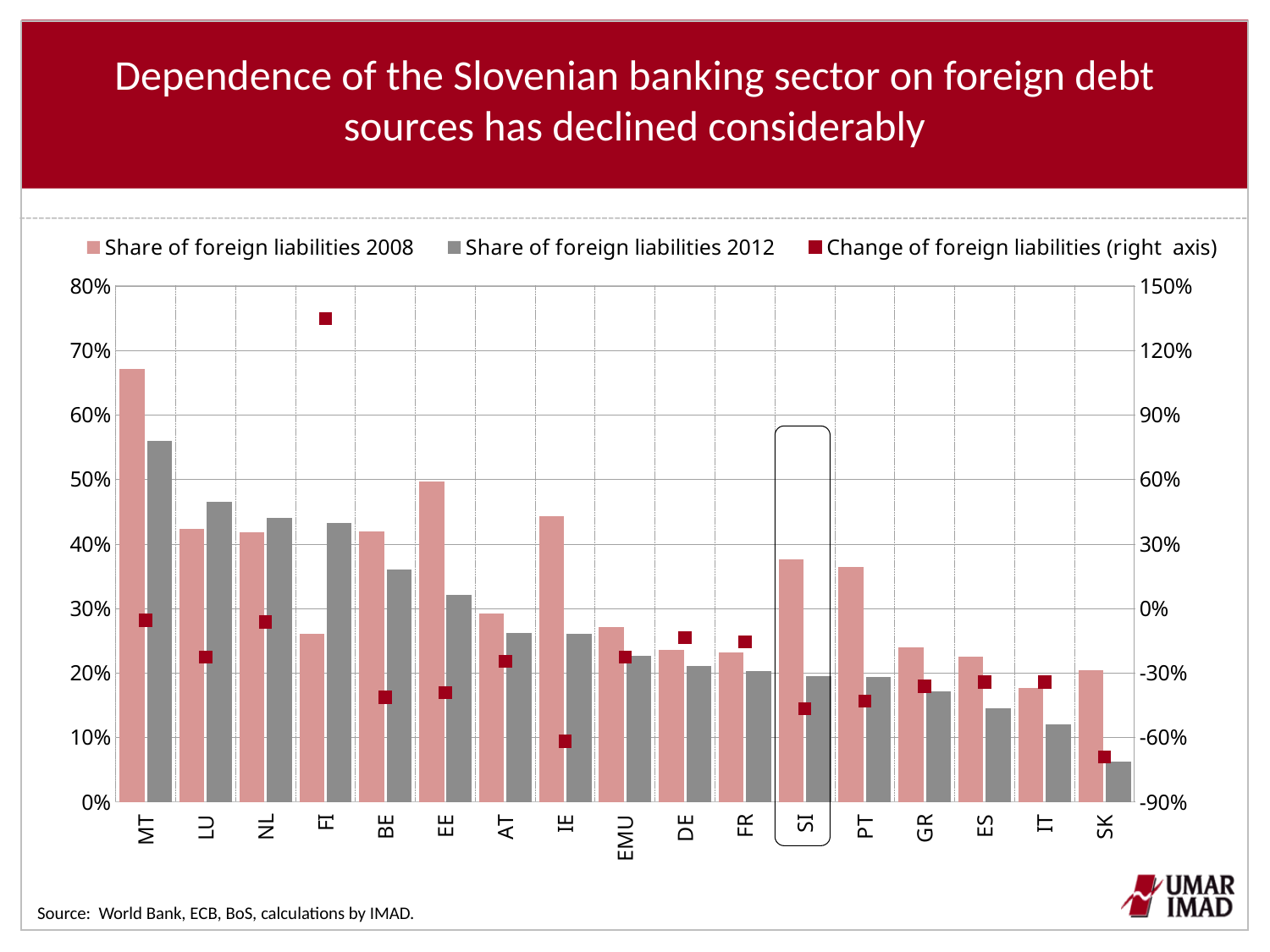
Is the change of foreign liabilities for FI greater or less than 120%? greater What kind of chart is shown on the slide? bar chart with markers (combination chart) How many series does the legend list? 3 For FI, which is larger: the share of foreign liabilities in 2008 or in 2012? 2012 Which category is highlighted with a box on the chart? SI Is the share of foreign liabilities 2008 for MT greater or less than 60%? greater How many countries/categories are shown on the x axis? 17 Which category has the lowest share of foreign liabilities in 2012? SK Which category has the highest share of foreign liabilities in 2008? MT Which category has the highest change of foreign liabilities (right axis)? FI For SI, which is larger: the share of foreign liabilities in 2008 or in 2012? 2008